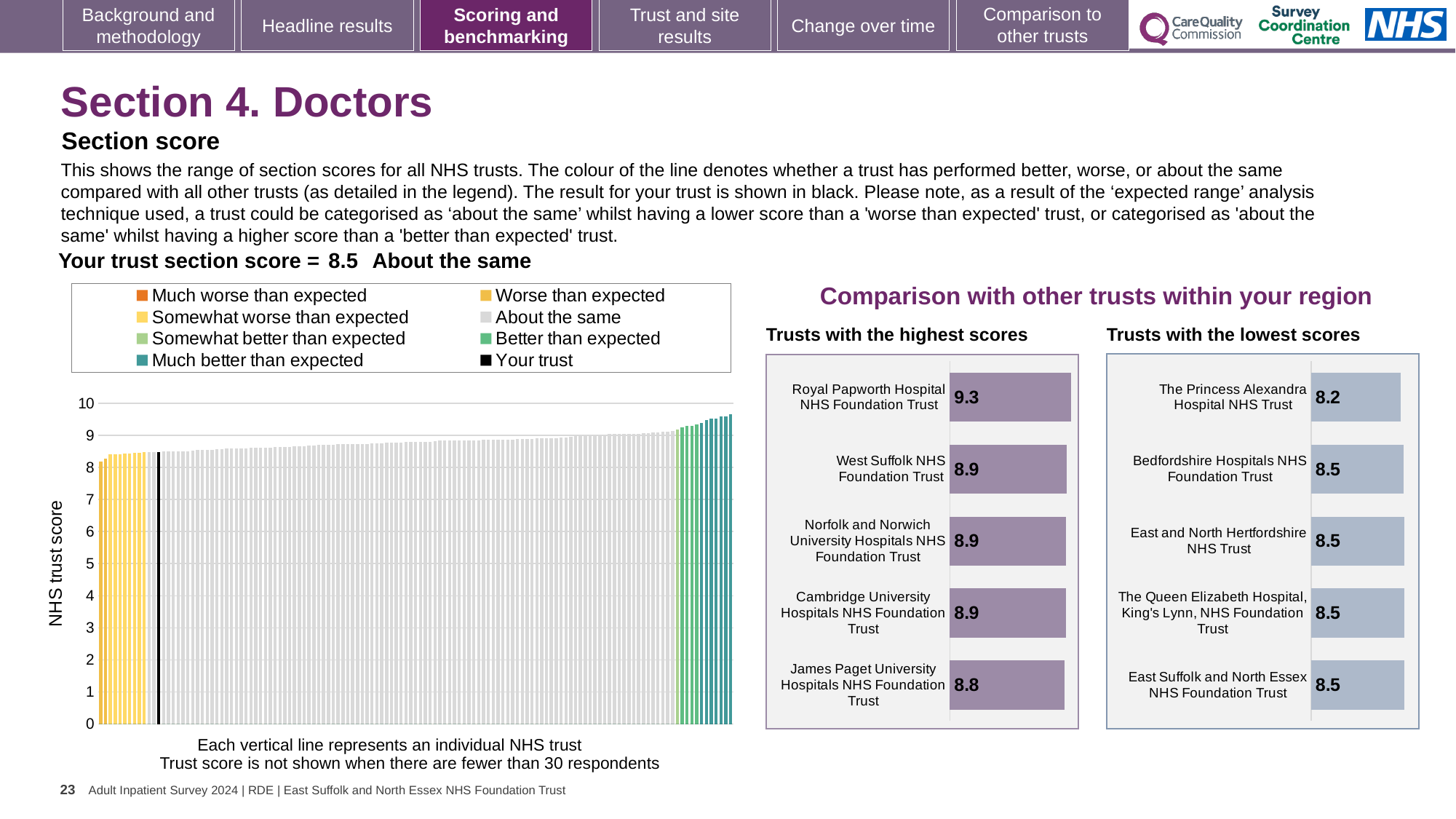
In the 'Trusts with the lowest scores' chart, what is the score for East Suffolk and North Essex NHS Foundation Trust? 8.5 Which is larger: the score for Royal Papworth Hospital NHS Foundation Trust in the highest scores chart, or the score for The Princess Alexandra Hospital NHS Trust in the lowest scores chart? Royal Papworth Hospital NHS Foundation Trust In the main section score chart on the left, do the trust scores rise or fall from left to right along the x axis? Rise What kind of chart is the main section score chart on the left? Bar chart In the 'Trusts with the lowest scores' chart, which trust has the lowest score? The Princess Alexandra Hospital NHS Trust In the 'Trusts with the highest scores' chart, what is the difference between the scores of Royal Papworth Hospital NHS Foundation Trust and James Paget University Hospitals NHS Foundation Trust? 0.5 In the 'Trusts with the highest scores' chart, which trust has the highest score? Royal Papworth Hospital NHS Foundation Trust In the 'Trusts with the highest scores' chart, what is the score for Royal Papworth Hospital NHS Foundation Trust? 9.3 In the main section score chart on the left, how many entries does the legend list? 8 In the 'Trusts with the highest scores' chart, what is the score for James Paget University Hospitals NHS Foundation Trust? 8.8 In the 'Trusts with the lowest scores' chart, how many trusts are listed? 5 In the 'Trusts with the lowest scores' chart, what is the score for The Princess Alexandra Hospital NHS Trust? 8.2